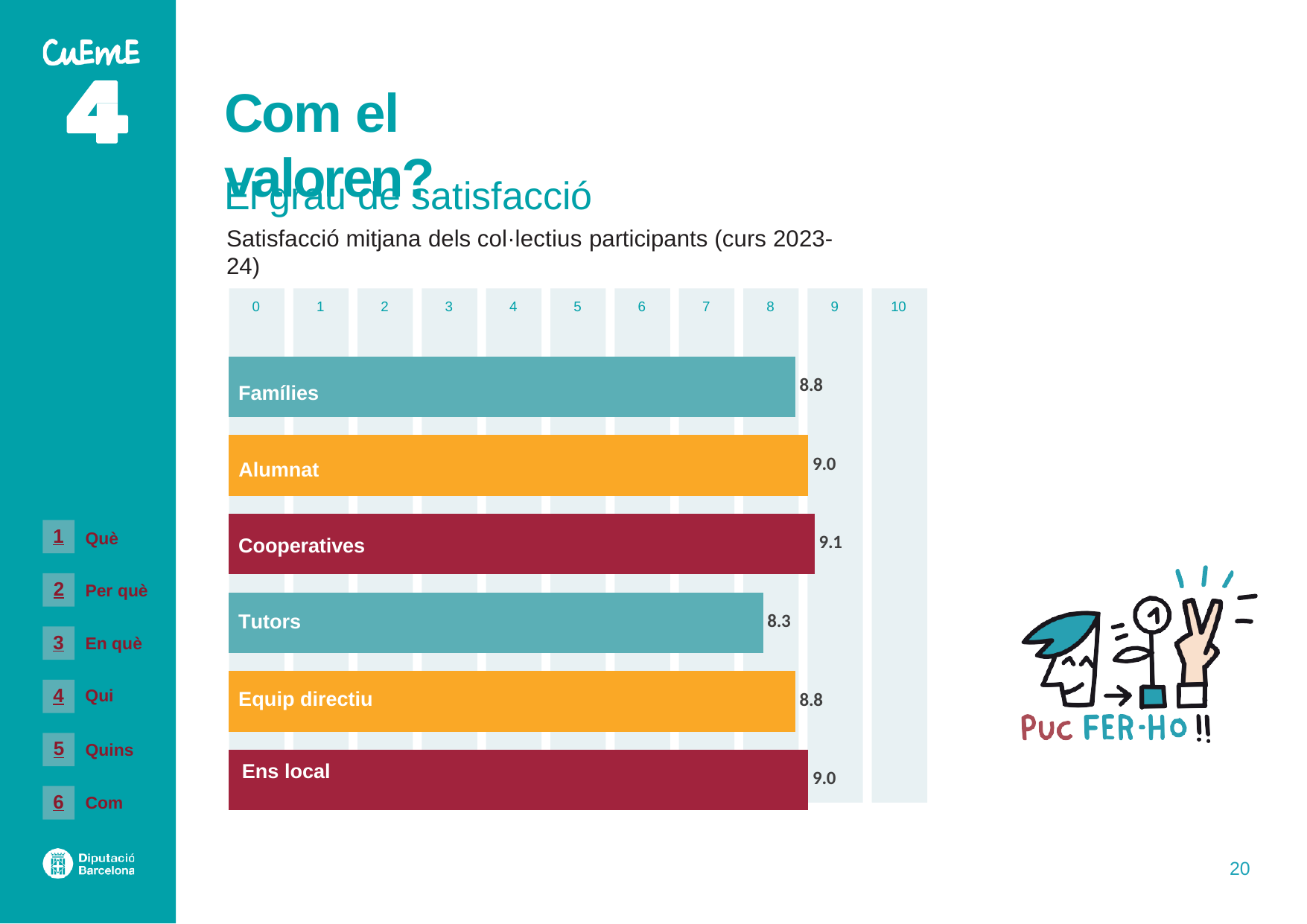
Which is larger, the value for Alumnat or the value for Tutors? Alumnat What is the title of the chart? Satisfacció mitjana dels col·lectius participants (curs 2023-24) Is the value for Tutors greater or less than 9? less How many groups are shown in the chart? 6 What is the satisfaction value for Ens local? 9.0 What is the difference between the values for Cooperatives and Tutors? 0.8 What is the satisfaction value for Cooperatives? 9.1 Which group has the lowest satisfaction value? Tutors Which group has the highest satisfaction value? Cooperatives What kind of chart is shown on the slide? bar chart What is the satisfaction value for Famílies? 8.8 What is the satisfaction value for Tutors? 8.3